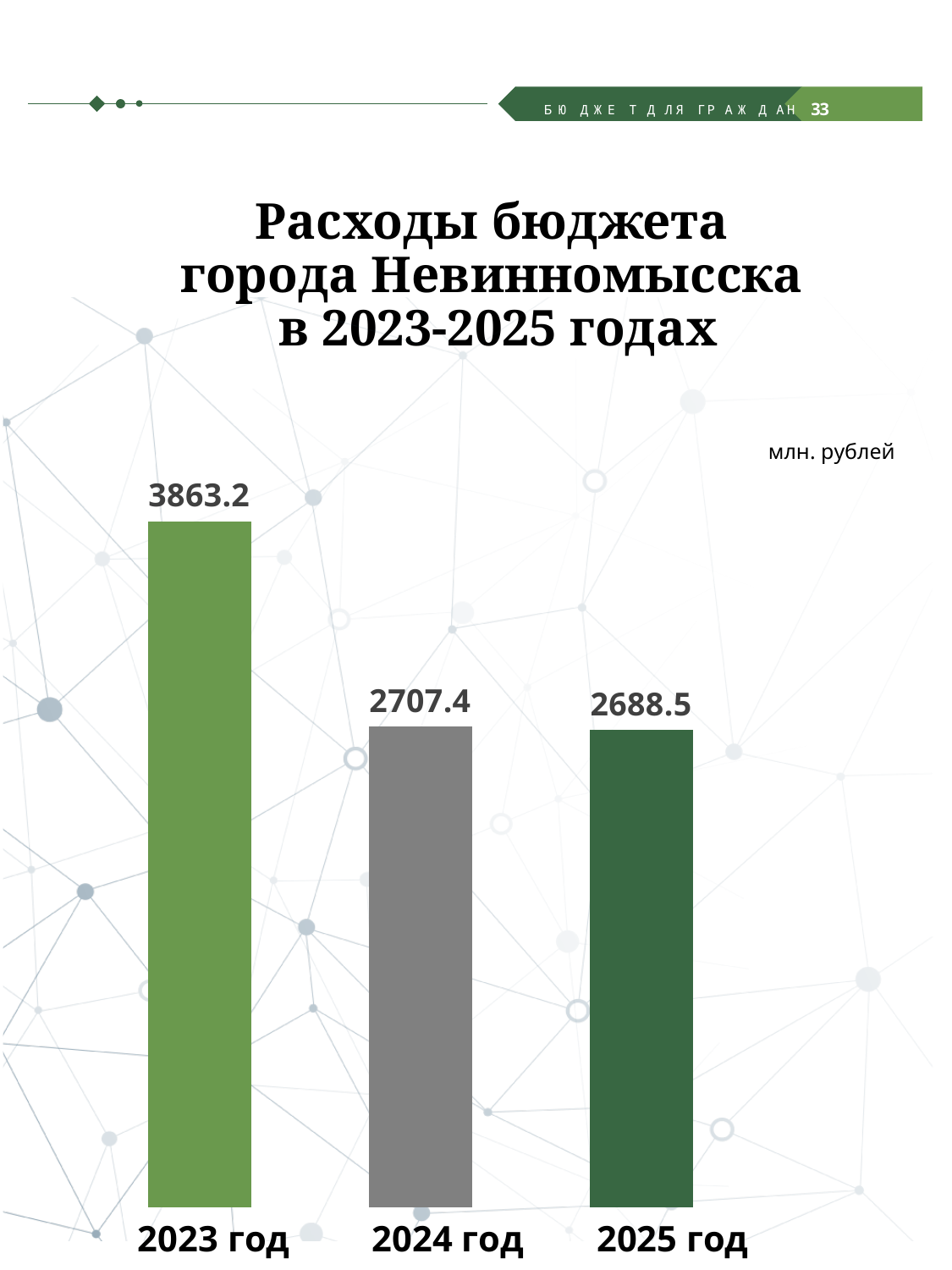
What is the budget expenditure value shown for 2023 год? 3863.2 In what units are the values on the chart expressed? млн. рублей What is the budget expenditure value shown for 2025 год? 2688.5 Which year has the lowest budget expenditure? 2025 год How many years (categories) are shown in the chart? 3 What is the budget expenditure value shown for 2024 год? 2707.4 What kind of chart is shown on the slide? Bar chart What is the difference between the expenditure for 2024 год and 2025 год? 18.9 What is the difference between the expenditure for 2023 год and 2024 год? 1155.8 Do the expenditure values rise or fall from 2023 год to 2025 год? Fall Which year has the highest budget expenditure? 2023 год Which is larger, the expenditure for 2023 год or 2025 год? 2023 год